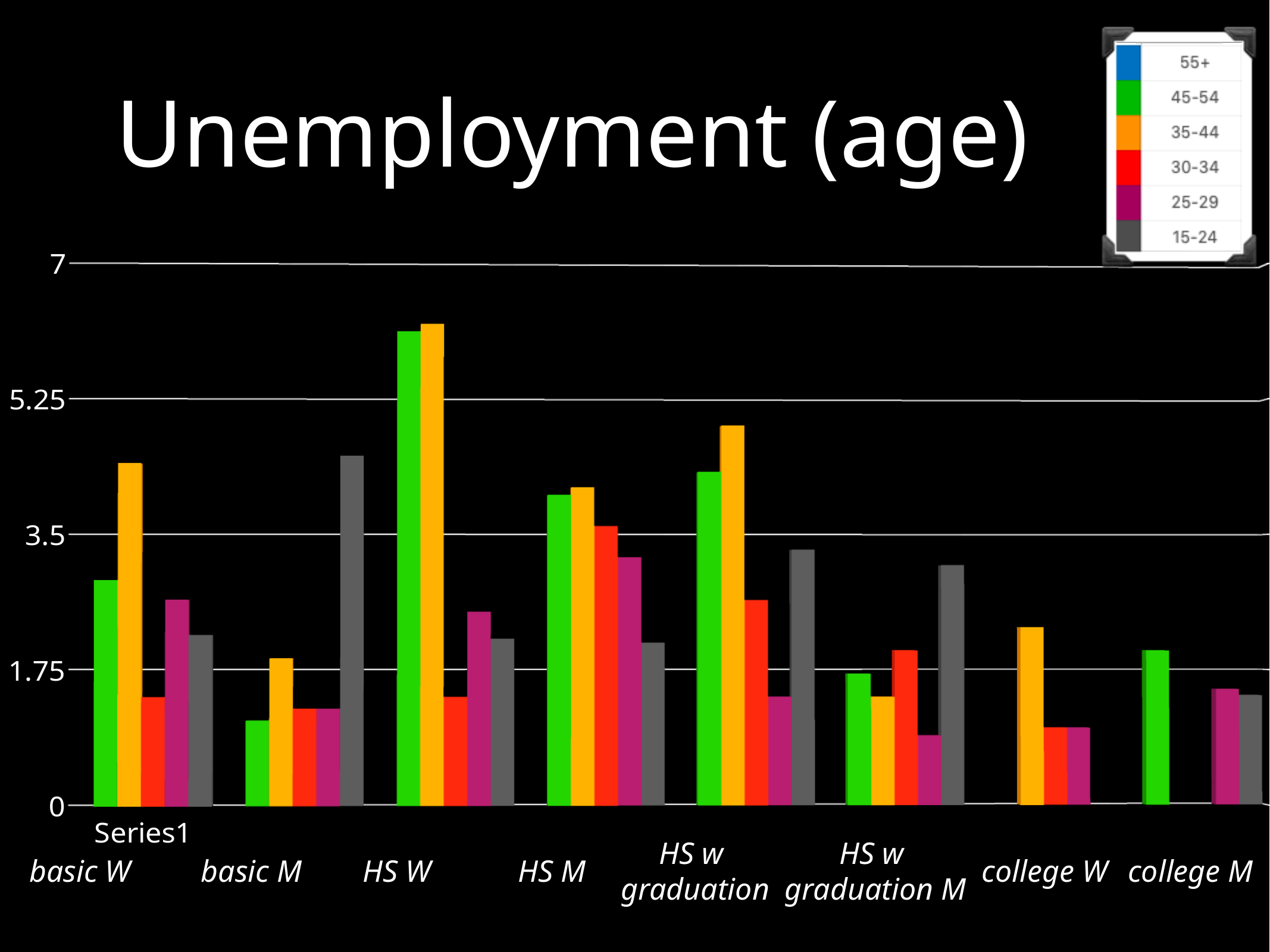
Is the value for the 35-44 series in the college W category greater or less than 1.75? greater Which is larger: the 15-24 value for basic M or the 15-24 value for basic W? basic M What is the title of the chart? Unemployment (age) How many categories are shown along the x axis? 8 Is the value for the 30-34 series in the basic W category greater or less than 1.75? less Is the value for the 35-44 series in the basic W category greater or less than 3.5? greater How many series does the legend list? 6 Which category has the highest value for the 35-44 series? HS W Which is larger: the 35-44 value for HS W or the 35-44 value for HS M? HS W What kind of chart is shown on the slide? bar chart